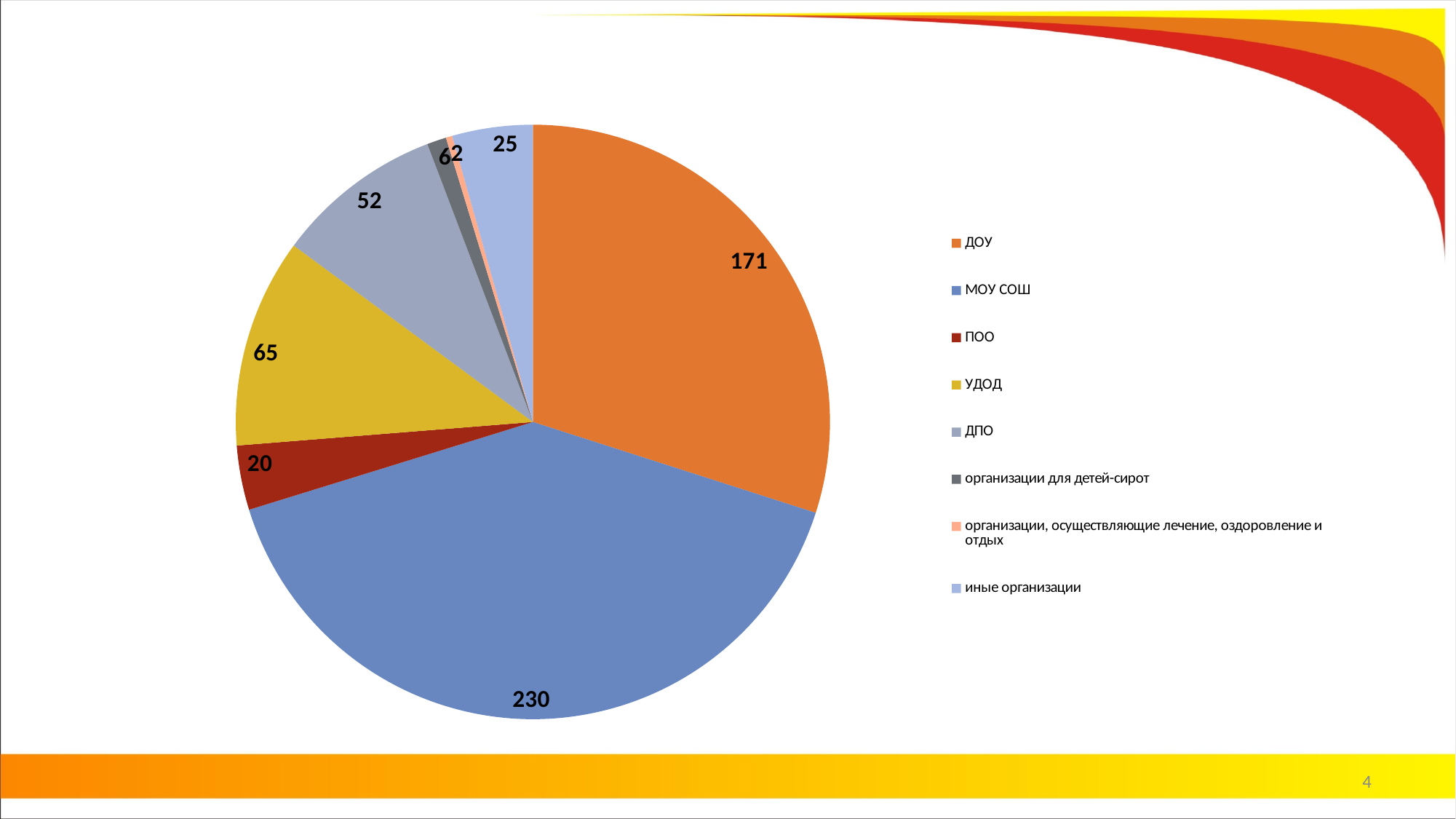
What kind of chart is shown on the slide? Pie chart What is the difference between the values for МОУ СОШ and ДОУ? 59 What is the value for иные организации in the pie chart? 25 What is the value for ДПО in the pie chart? 52 Which is larger, the value for ДОУ or the value for УДОД? ДОУ How many categories does the pie chart show? 8 What is the value for МОУ СОШ in the pie chart? 230 What is the value for УДОД in the pie chart? 65 What is the difference between the values for УДОД and ДПО? 13 What is the value for ДОУ in the pie chart? 171 Which category has the largest slice in the pie chart? МОУ СОШ What is the value for ПОО in the pie chart? 20